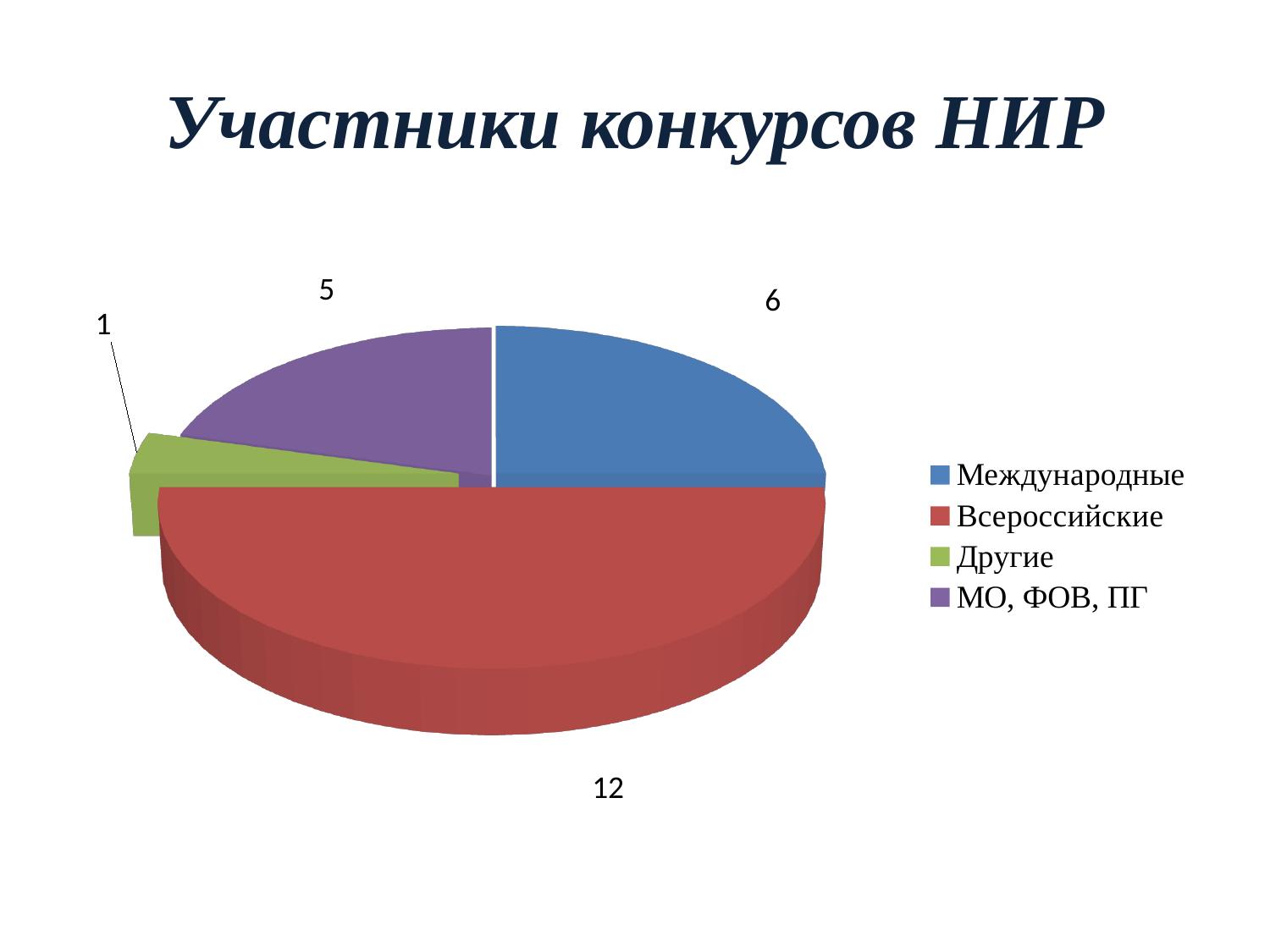
What is the value for Международные? 6 Which is larger, the value for Международные or the value for МО, ФОВ, ПГ? Международные What is the value for МО, ФОВ, ПГ? 5 What is the difference between the values for Всероссийские and Международные? 6 How many categories does the legend list? 4 What is the value for Всероссийские? 12 What share of the pie does Всероссийские represent? 50% What is the value for Другие? 1 Which category has the smallest slice? Другие What kind of chart is shown on the slide? Pie chart Which category has the largest slice? Всероссийские What is the title of the chart? Участники конкурсов НИР